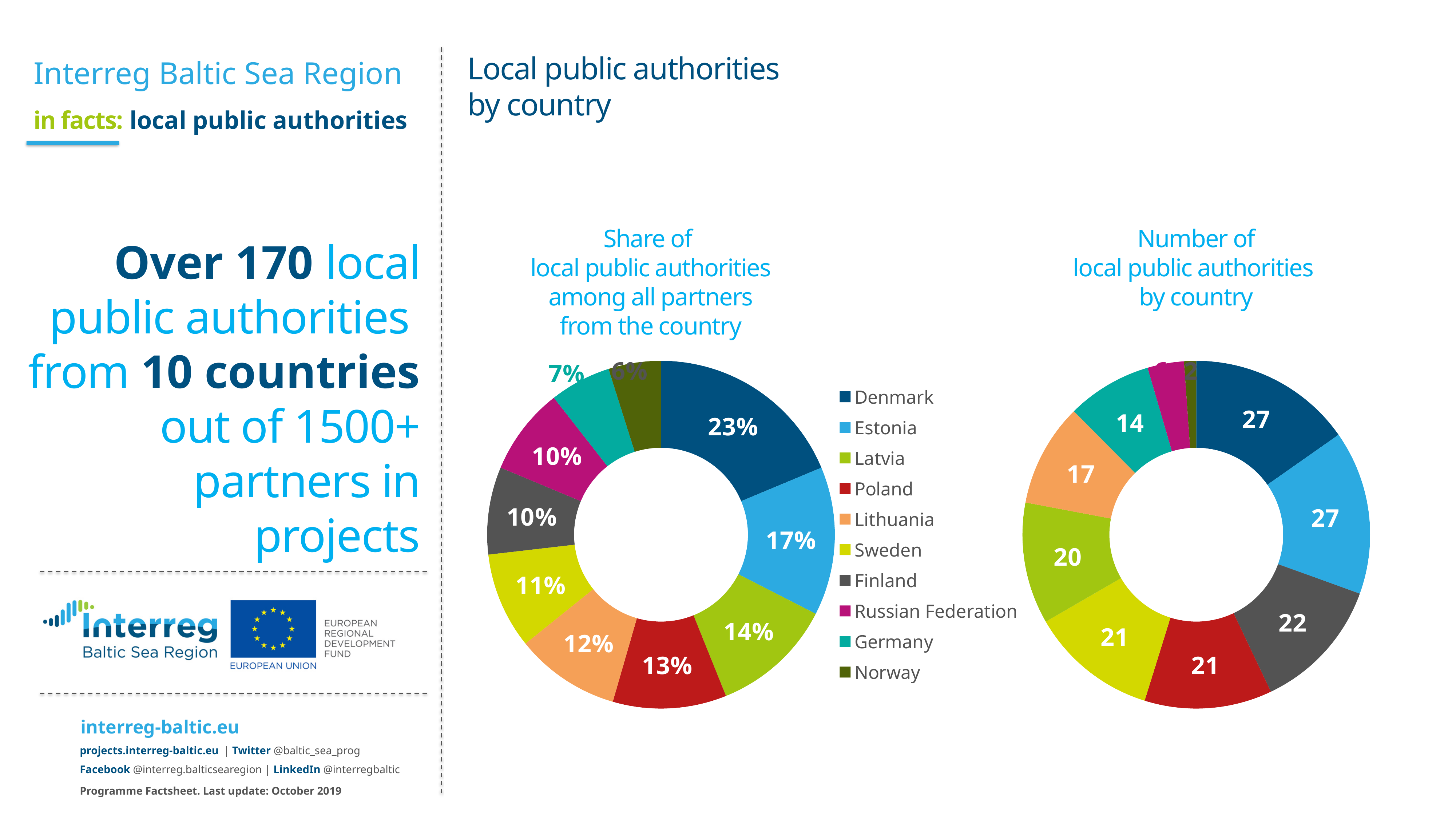
On the 'Share of local public authorities among all partners from the country' chart, what is the value for Poland? 13% On the 'Share of local public authorities among all partners from the country' chart, what is the value for Estonia? 17% How many countries are listed in the legend shared by the two charts? 10 On the 'Number of local public authorities by country' chart, what is the value for Germany? 14 On the 'Number of local public authorities by country' chart, what is the value for Finland? 22 What kind of chart is the 'Number of local public authorities by country' chart? Doughnut chart On the 'Share of local public authorities among all partners from the country' chart, what is the difference between the values for Denmark and Estonia? 6% On the 'Share of local public authorities among all partners from the country' chart, which country has the lowest share? Norway On the 'Share of local public authorities among all partners from the country' chart, what is the value for Denmark? 23% On the 'Number of local public authorities by country' chart, which is larger, the value for Latvia or the value for Lithuania? Latvia On the 'Share of local public authorities among all partners from the country' chart, which country has the highest share? Denmark On the 'Number of local public authorities by country' chart, what is the value for Lithuania? 17